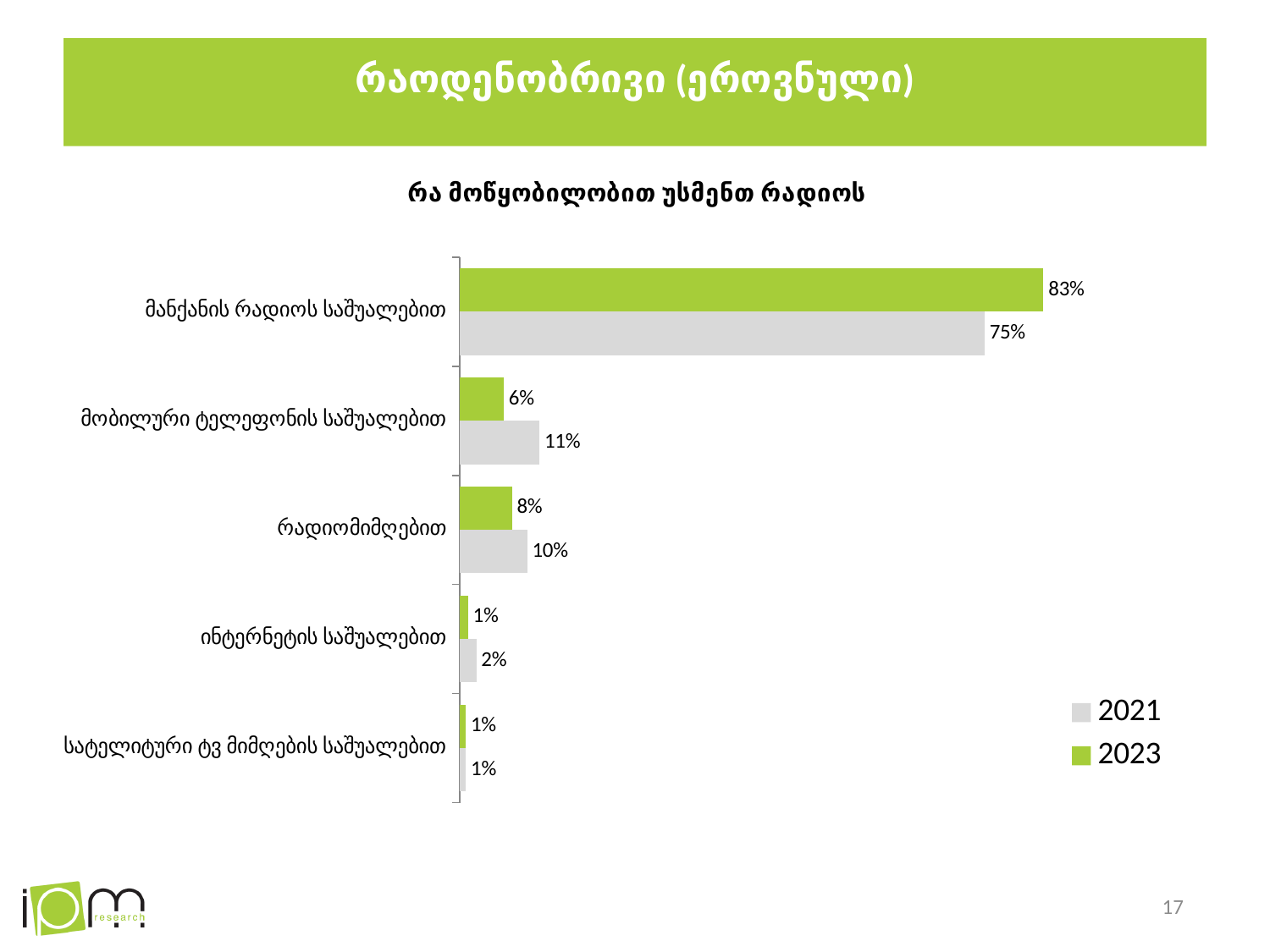
What is the 2021 value for ინტერნეტის საშუალებით? 2% What is the difference between the 2021 and 2023 values for მობილური ტელეფონის საშუალებით? 5% Which category has the lowest 2021 value? სატელიტური ტვ მიმღების საშუალებით What is the 2023 value for მანქანის რადიოს საშუალებით? 83% What kind of chart is shown on the slide? Bar chart For რადიომიმღებით, which year has the larger value, 2021 or 2023? 2021 How many series does the legend list? 2 What is the 2021 value for მობილური ტელეფონის საშუალებით? 11% Which category has the highest 2023 value? მანქანის რადიოს საშუალებით What is the difference between the 2023 and 2021 values for მანქანის რადიოს საშუალებით? 8% What is the 2023 value for რადიომიმღებით? 8% How many categories are shown in the chart? 5